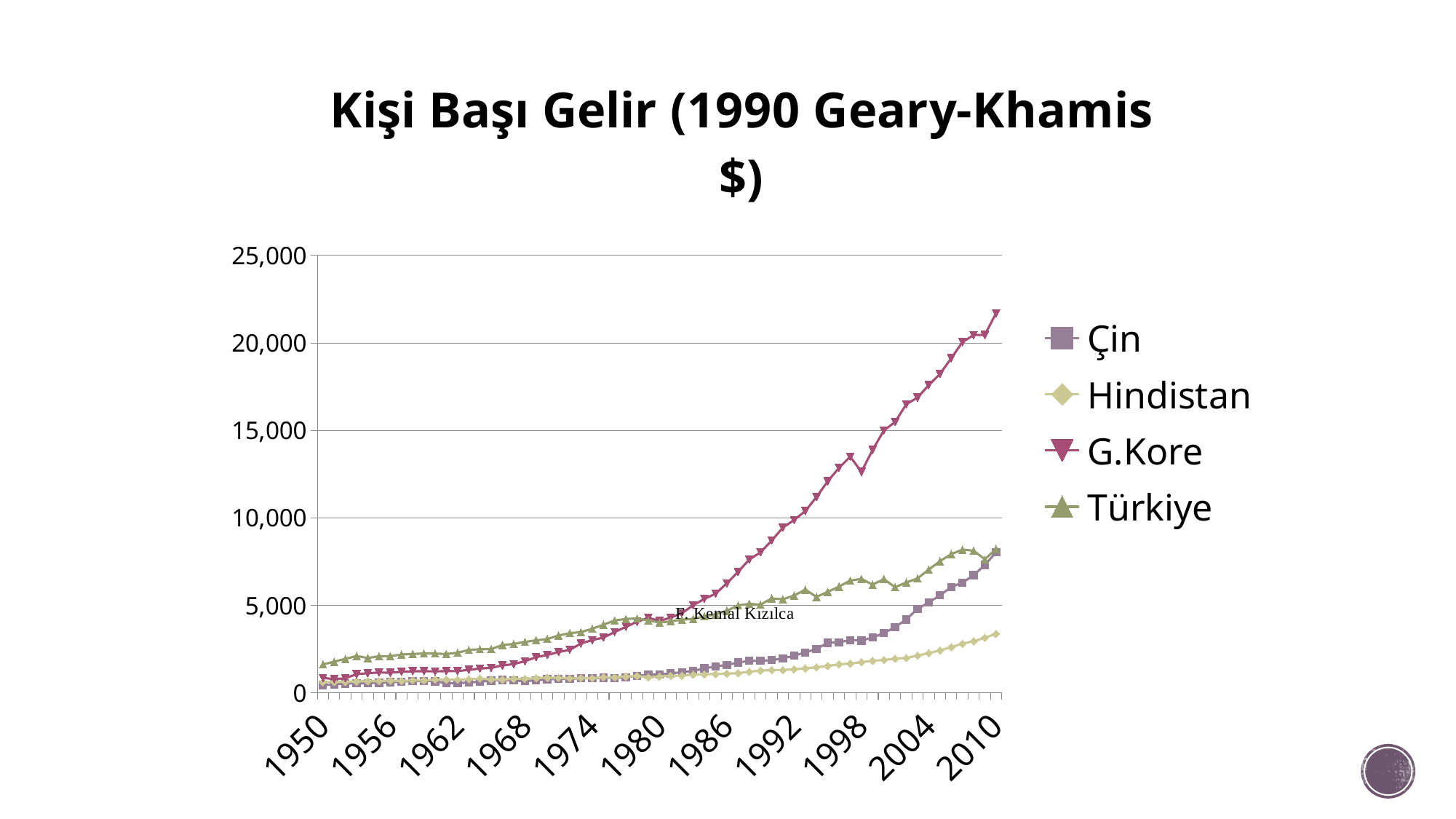
Which series has the highest value in 1950? Türkiye Is the value for G.Kore in 2010 greater or less than 20,000? greater Which series has the highest value in 2010? G.Kore Which series has the lowest value in 2010? Hindistan Is the value for Türkiye in 2010 greater or less than 10,000? less Is the value for Çin in 2010 greater or less than 5,000? greater How many series does the legend list? 4 In 1992, which is larger: the value for G.Kore or the value for Türkiye? G.Kore Does the value for G.Kore generally rise or fall from 1950 to 2010? rise What is the title of the chart? Kişi Başı Gelir (1990 Geary-Khamis $) What kind of chart is shown on the slide? line chart